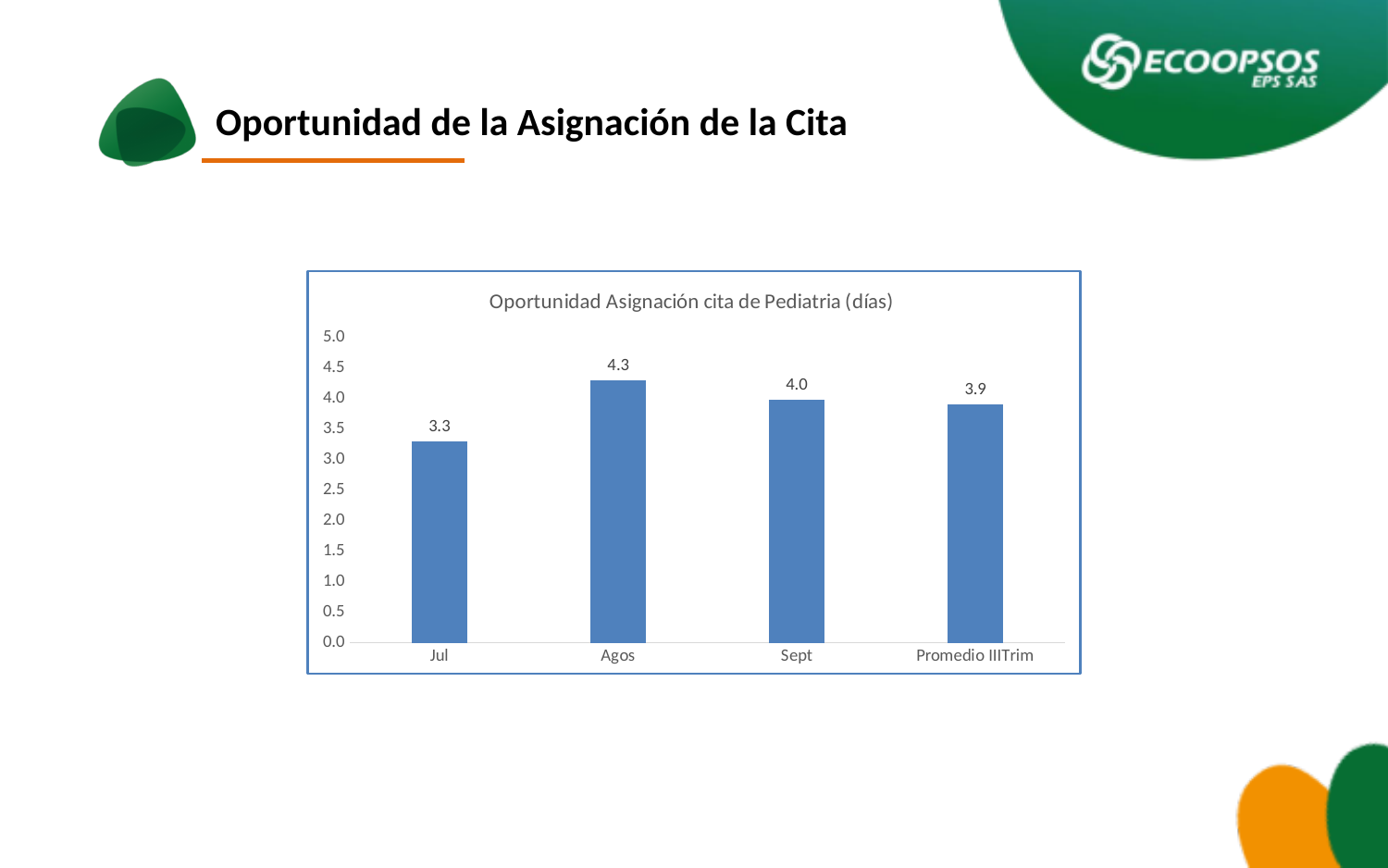
What is the value for Jul? 3.3 Which category has the lowest value? Jul What is the value for Agos? 4.3 What is the value for Promedio IIITrim? 3.9 What is the title of the chart? Oportunidad Asignación cita de Pediatria (días) Is the value for Agos greater or less than 4.0? greater What is the difference between the values for Agos and Jul? 1.0 What is the value for Sept? 4.0 Which is larger, the value for Sept or the value for Jul? Sept How many categories are shown on the x axis? 4 What kind of chart is shown? bar chart Which category has the highest value? Agos